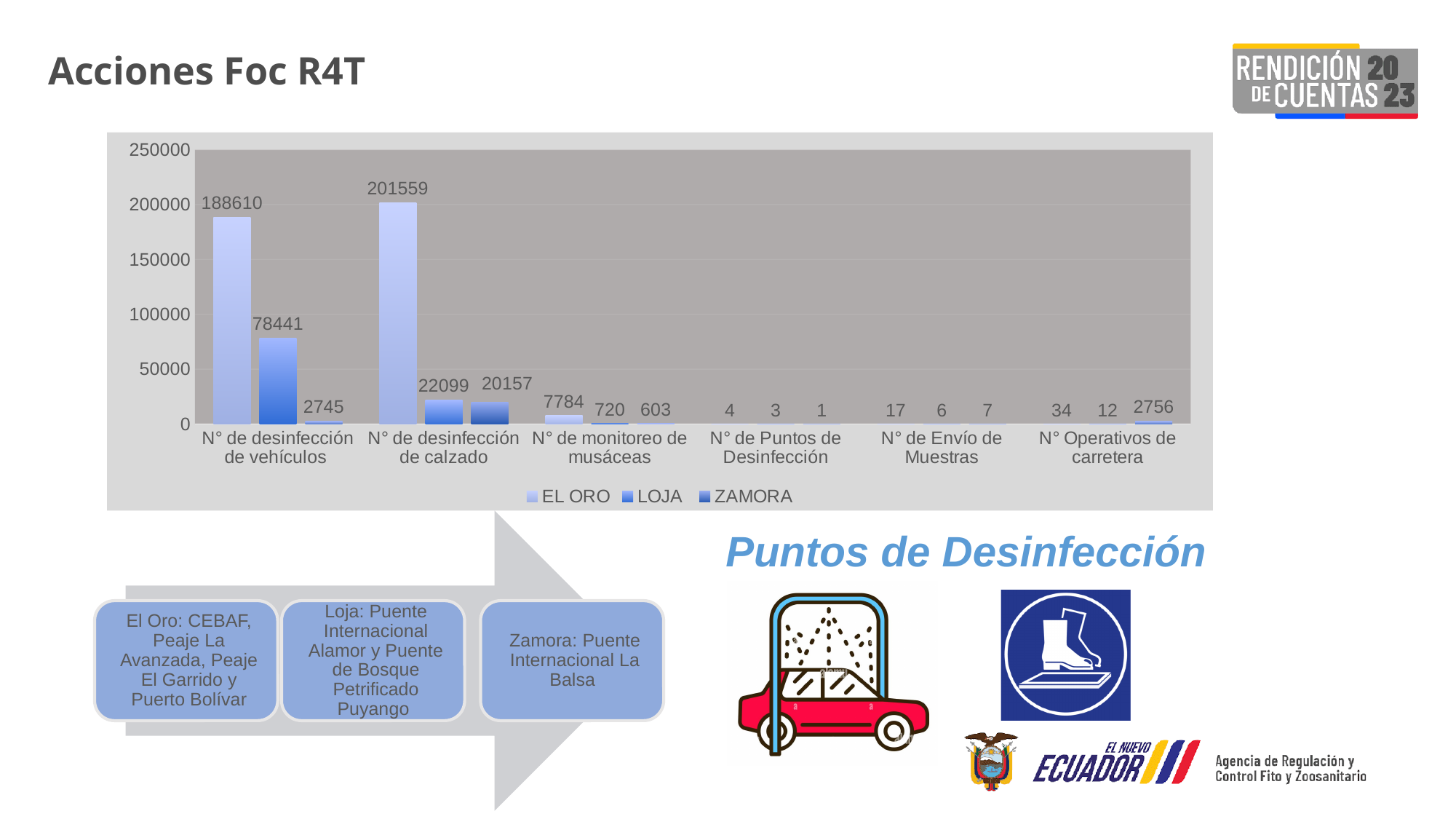
Which series has the lowest value in the 'N° de Puntos de Desinfección' category? ZAMORA Which is larger in the 'N° de Envío de Muestras' category, LOJA or ZAMORA? ZAMORA What is the value for EL ORO in the 'N° de desinfección de calzado' category? 201559 What kind of chart is shown on the slide? Bar chart Which category has the highest EL ORO value? N° de desinfección de calzado How many categories are shown on the x axis of the chart? 6 What are the three series named in the chart legend? EL ORO, LOJA, ZAMORA What is the value for ZAMORA in the 'N° Operativos de carretera' category? 2756 How many series does the chart legend list? 3 What is the value for EL ORO in the 'N° de monitoreo de musáceas' category? 7784 What is the difference between the EL ORO and LOJA values for 'N° de desinfección de vehículos'? 110169 What is the value for LOJA in the 'N° de desinfección de vehículos' category? 78441